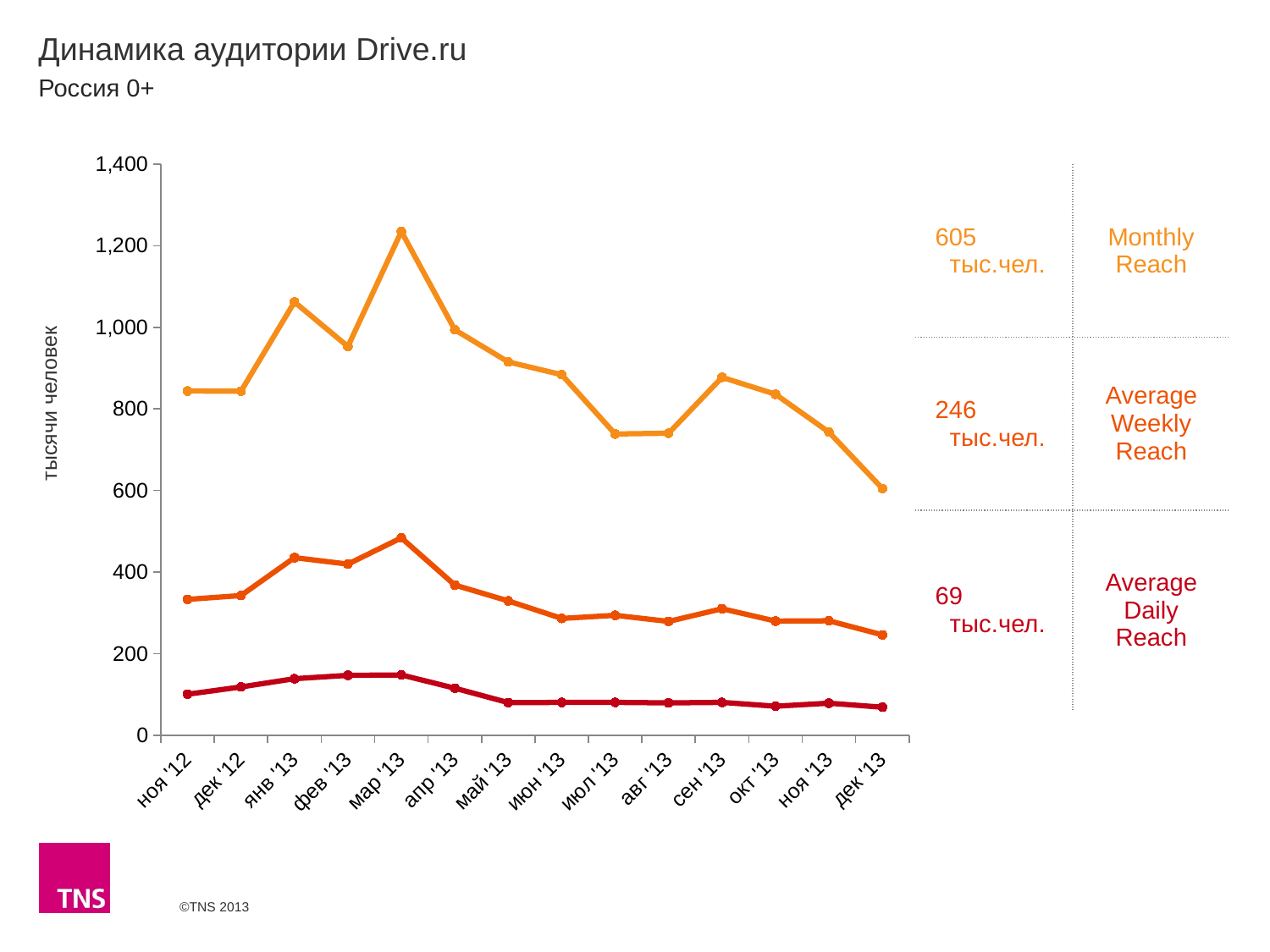
What is the Monthly Reach in дек '13? 605 тыс.чел. Is the Average Weekly Reach in мар '13 greater or less than 400? greater What is the Average Weekly Reach in дек '13? 246 тыс.чел. Which month has the larger Monthly Reach, янв '13 or фев '13? янв '13 In which month is the Monthly Reach highest? мар '13 What is the difference between the Monthly Reach and the Average Weekly Reach in дек '13? 359 тыс.чел. How many months are plotted along the x axis? 14 What is the Average Daily Reach in дек '13? 69 тыс.чел. How many series (lines) are plotted on the chart? 3 Is the Monthly Reach in мар '13 greater or less than 1,200? greater In which month is the Monthly Reach lowest? дек '13 What kind of chart is shown on the slide? line chart